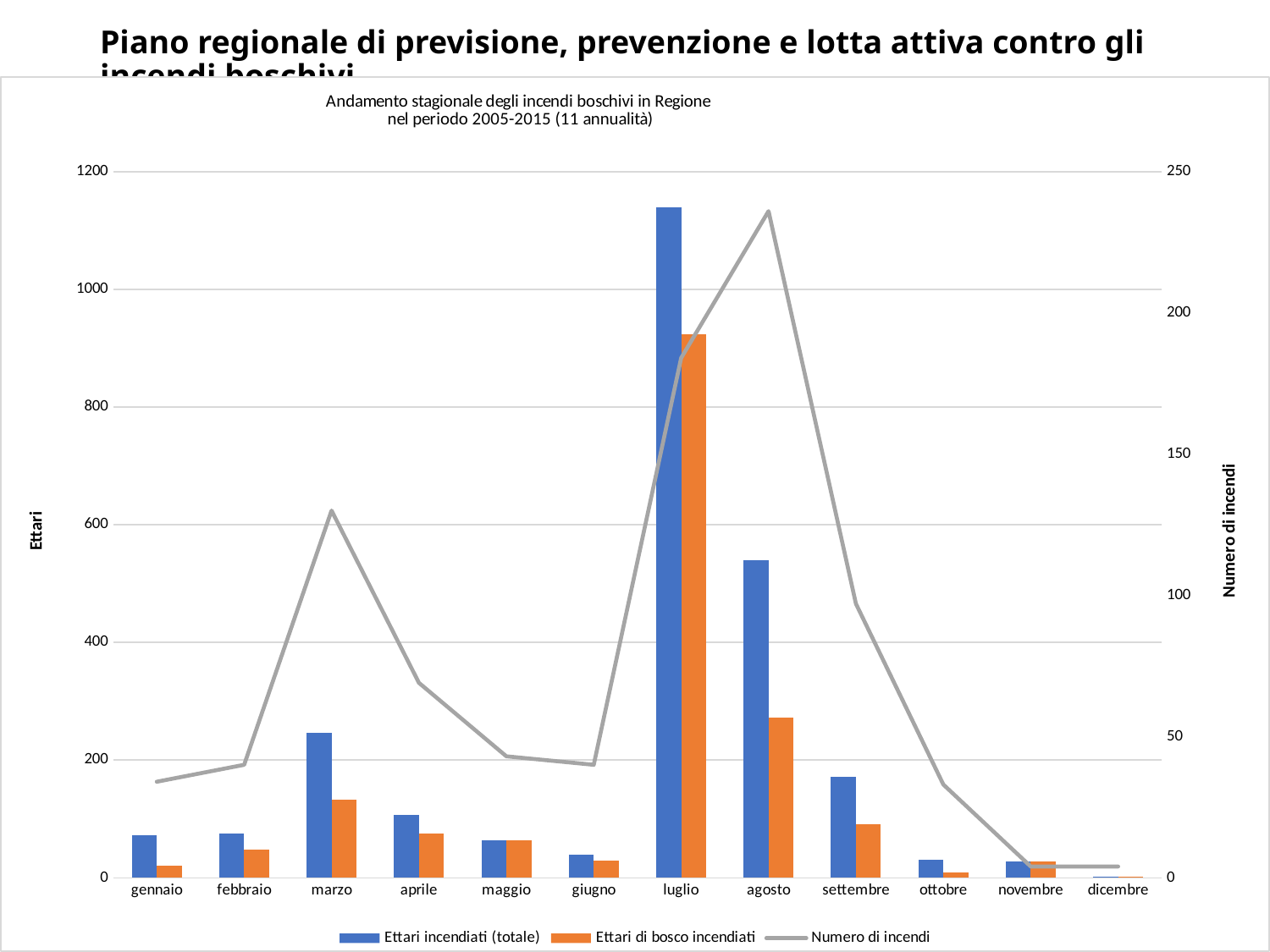
Which month has the highest value for Numero di incendi? agosto Which month has the highest value for Ettari incendiati (totale)? luglio Which month has the larger value for Ettari incendiati (totale), marzo or aprile? marzo How many months are shown on the x axis? 12 Is the value for Ettari incendiati (totale) in agosto greater or less than 600? less Is the value for Ettari incendiati (totale) in luglio greater or less than 1000? greater Which month has the larger value for Numero di incendi, luglio or agosto? agosto What is the title of the right-hand vertical axis? Numero di incendi What kind of chart is shown on the slide? A combined bar and line chart How many series does the legend list? 3 Which month has the lowest value for Ettari incendiati (totale)? dicembre Is the value for Numero di incendi in marzo greater or less than 100? greater